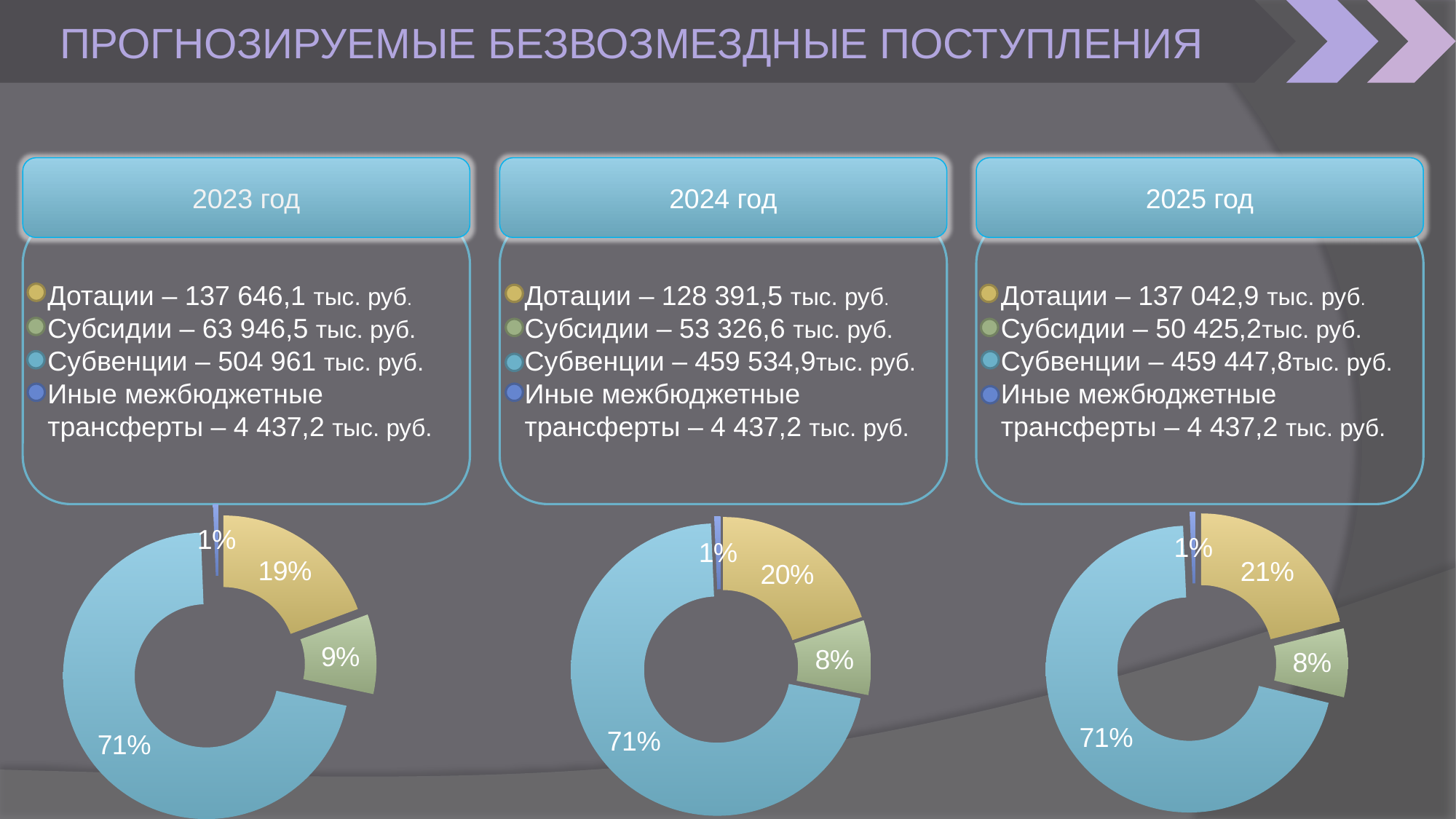
In the 2024 год chart, which category has the smallest slice? Иные межбюджетные трансферты In the 2025 год chart, what share is shown for Дотации (yellow slice)? 21% In the 2024 год chart, what share is shown for Дотации (yellow slice)? 20% In the 2023 год chart, what is the difference in percentage points between the Дотации slice and the Субсидии slice? 10 percentage points In the 2025 год chart, which category has the largest slice? Субвенции In the 2023 год chart, what share is shown for Субвенции (light blue slice)? 71% How many doughnut charts are shown on the slide? 3 What kind of chart is used for the 2023 год data? doughnut (pie) chart How many slices does each doughnut chart on the slide contain? 4